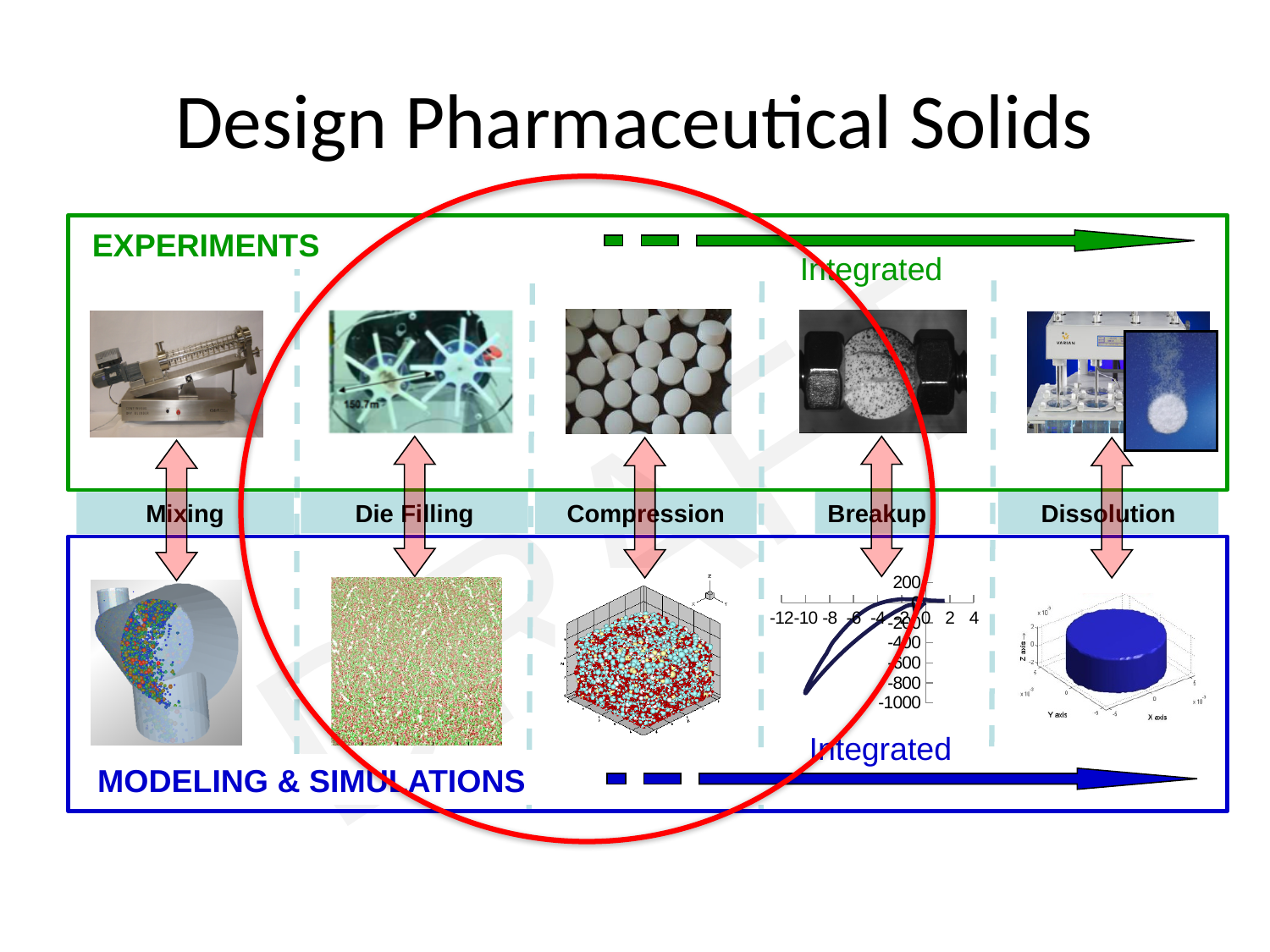
In the line chart under Breakup, what is the highest value labelled on the y axis? 200 In the line chart under Breakup, do the plotted values rise or fall as the x-axis value increases from -12 toward 4? rise What kind of chart is shown in the Modeling & Simulations row under the Breakup stage? line chart In the line chart under Breakup, what is the lowest value labelled on the y axis? -1000 In the line chart under Breakup, what is the rightmost value labelled on the x axis? 4 In the line chart under Breakup, what is the leftmost value labelled on the x axis? -12